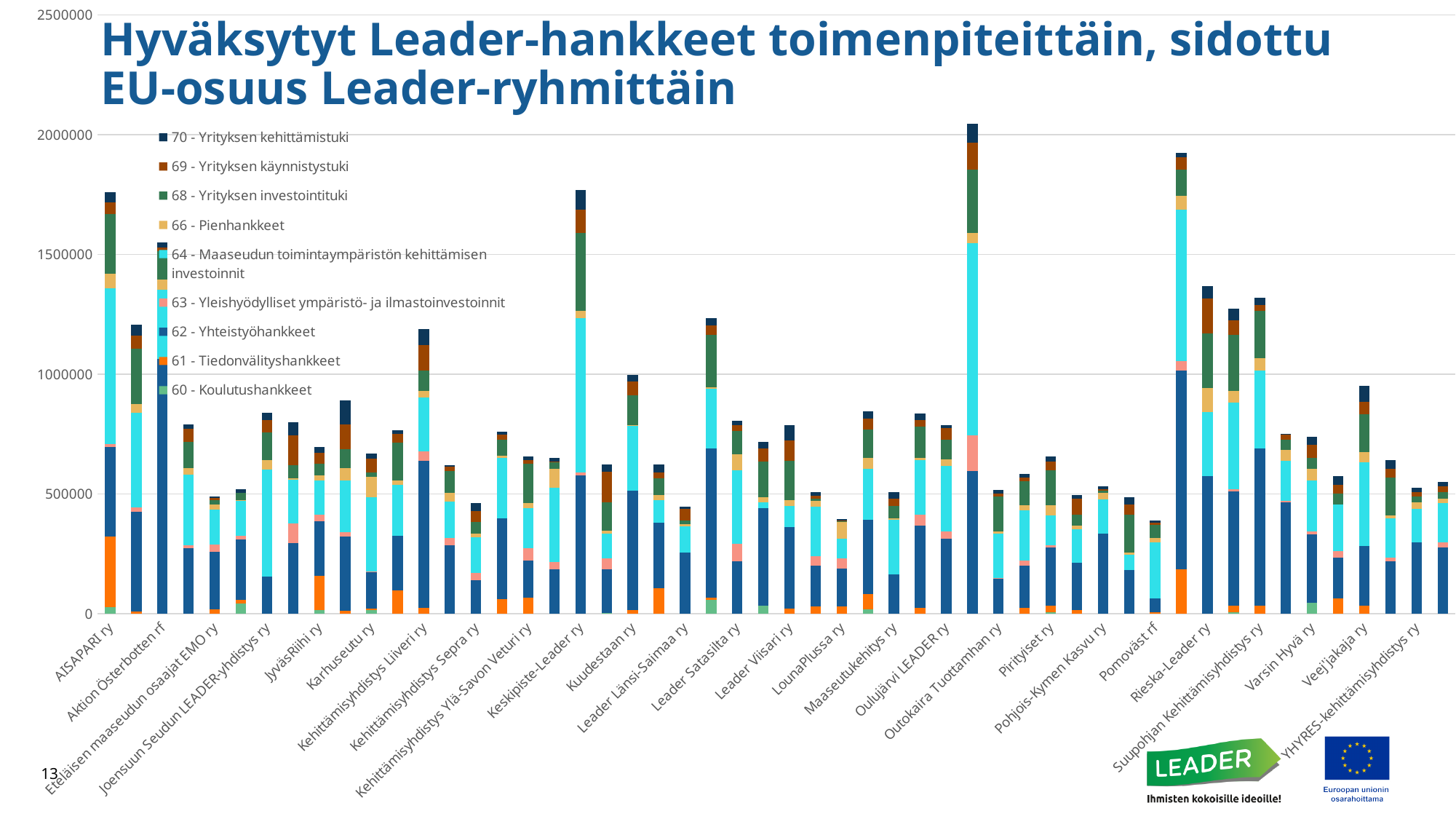
Is the total value for LounaPlussa ry greater or less than 500000? less Is the total value for Rieska-Leader ry greater or less than 1000000? greater Is the total value for AISAPARI ry greater or less than 1500000? greater How many series does the legend list? 9 What is the title of the chart? Hyväksytyt Leader-hankkeet toimenpiteittäin, sidottu EU-osuus Leader-ryhmittäin What kind of chart is shown on the slide? Stacked bar chart Which legend entry is listed first? 70 - Yrityksen kehittämistuki Which has the larger total, Keskipiste-Leader ry or LounaPlussa ry? Keskipiste-Leader ry Which has the larger total, AISAPARI ry or Pomoväst rf? AISAPARI ry